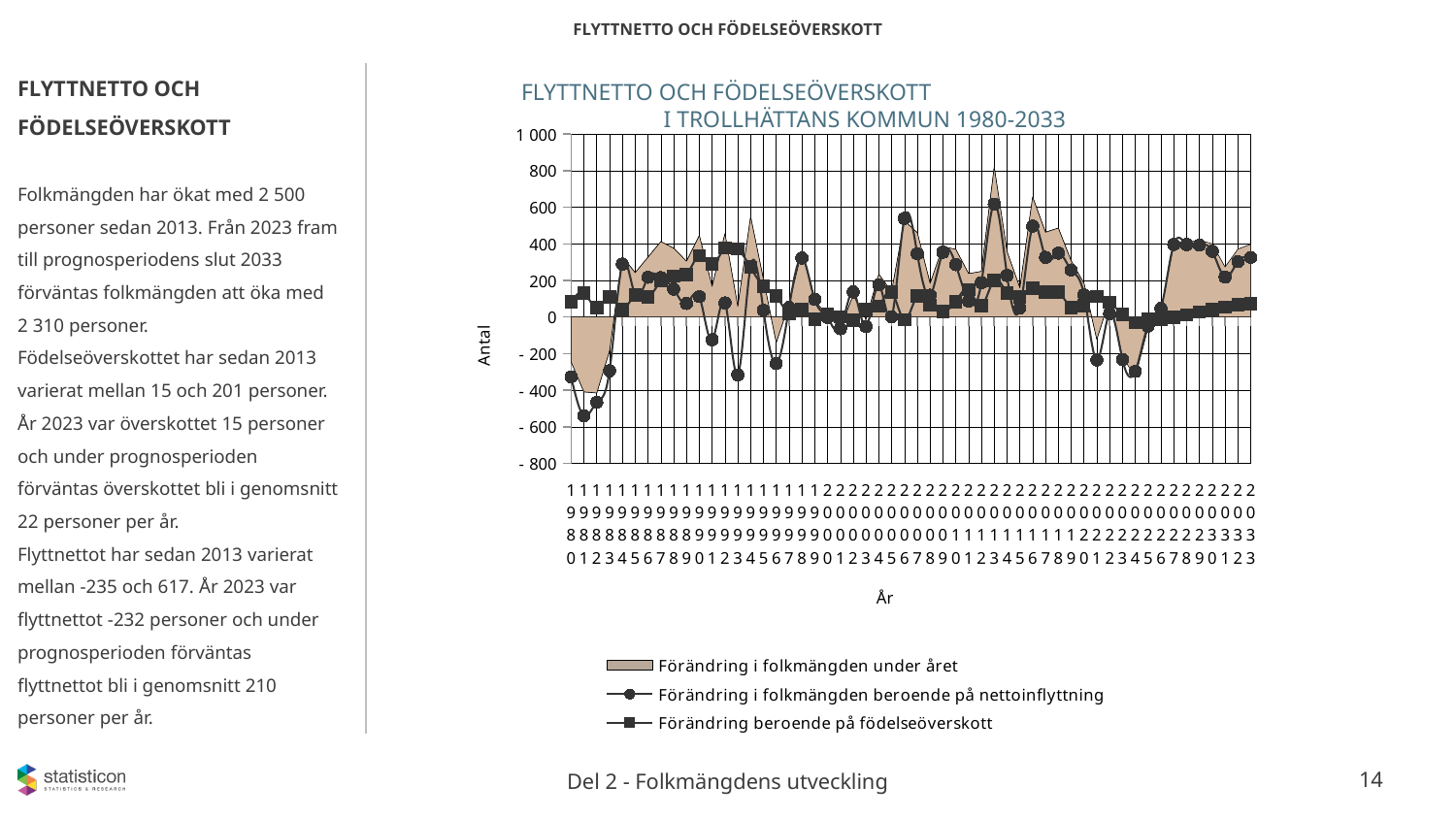
What kind of chart is shown on the slide? A combined area and line chart Is the highest value of the 'Förändring i folkmängden under året' series greater or less than 600? greater What is the label on the chart's vertical axis? Antal How many years does the chart cover, from 1980 to 2033? 54 Is the lowest value of the 'Förändring i folkmängden beroende på nettoinflyttning' series greater or less than -400? less Is the value of 'Förändring i folkmängden beroende på nettoinflyttning' in 1980 greater or less than -200? less Which series reaches the lowest value anywhere on the chart? Förändring i folkmängden beroende på nettoinflyttning How many series does the chart's legend list? 3 In 1981, which series has the lower value: 'Förändring i folkmängden beroende på nettoinflyttning' or 'Förändring beroende på födelseöverskott'? Förändring i folkmängden beroende på nettoinflyttning What is the title of the chart? FLYTTNETTO OCH FÖDELSEÖVERSKOTT I TROLLHÄTTANS KOMMUN 1980-2033